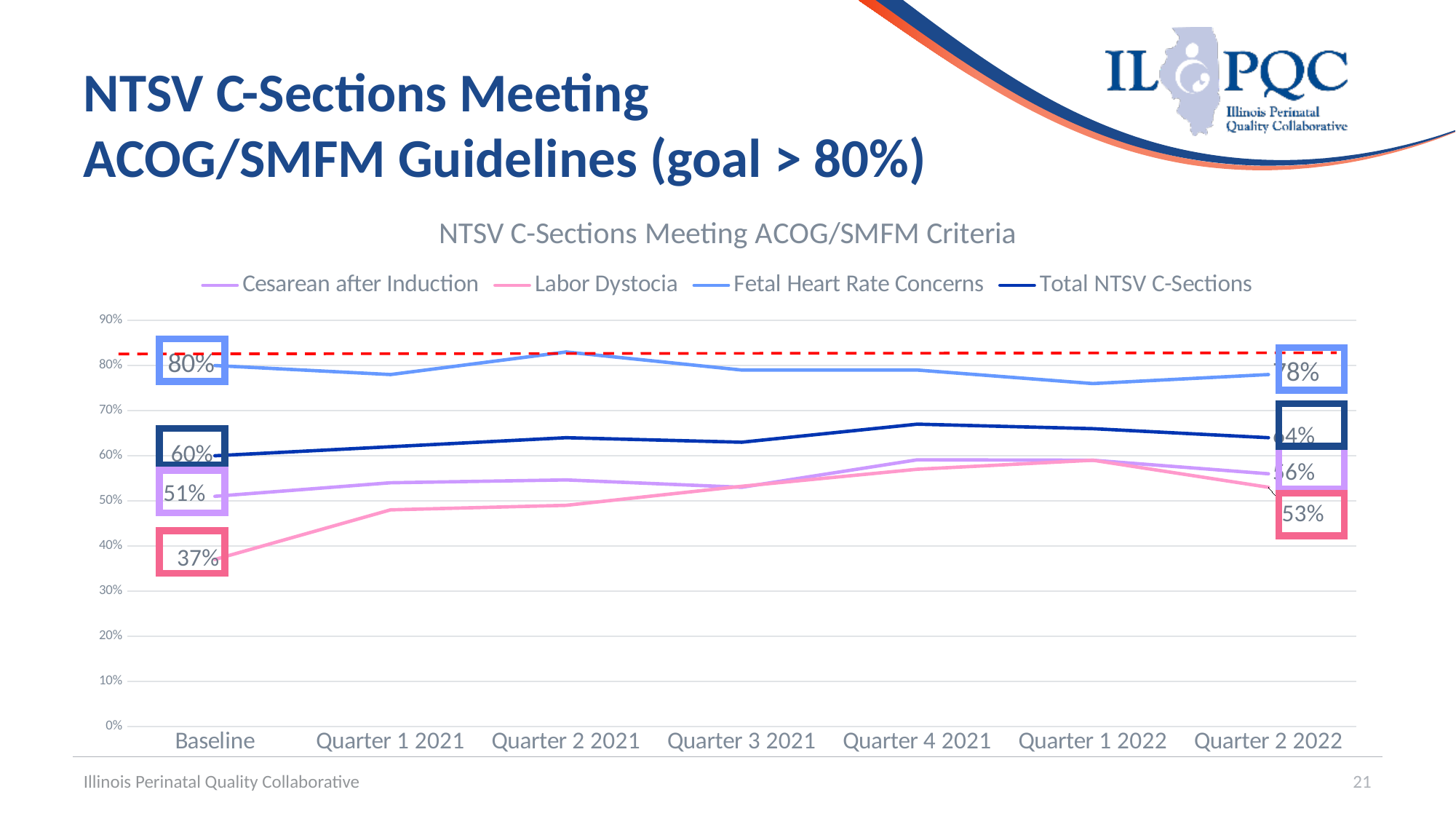
What kind of chart is shown on the slide? Line chart Is the value for Total NTSV C-Sections at Quarter 4 2021 greater or less than 60%? greater How many series does the legend list? 4 Which series has the lowest value at Baseline? Labor Dystocia What is the title of the chart? NTSV C-Sections Meeting ACOG/SMFM Criteria What is the value for Fetal Heart Rate Concerns at Baseline? 80% By how many percentage points did Labor Dystocia change from Baseline (37%) to Quarter 2 2022 (53%)? 16 percentage points What is the value for Labor Dystocia at Quarter 2 2022? 53% How many time periods are shown along the x axis? 7 What is the value for Total NTSV C-Sections at Baseline? 60% What is the value for Cesarean after Induction at Baseline? 51% What is the value for Labor Dystocia at Baseline? 37%